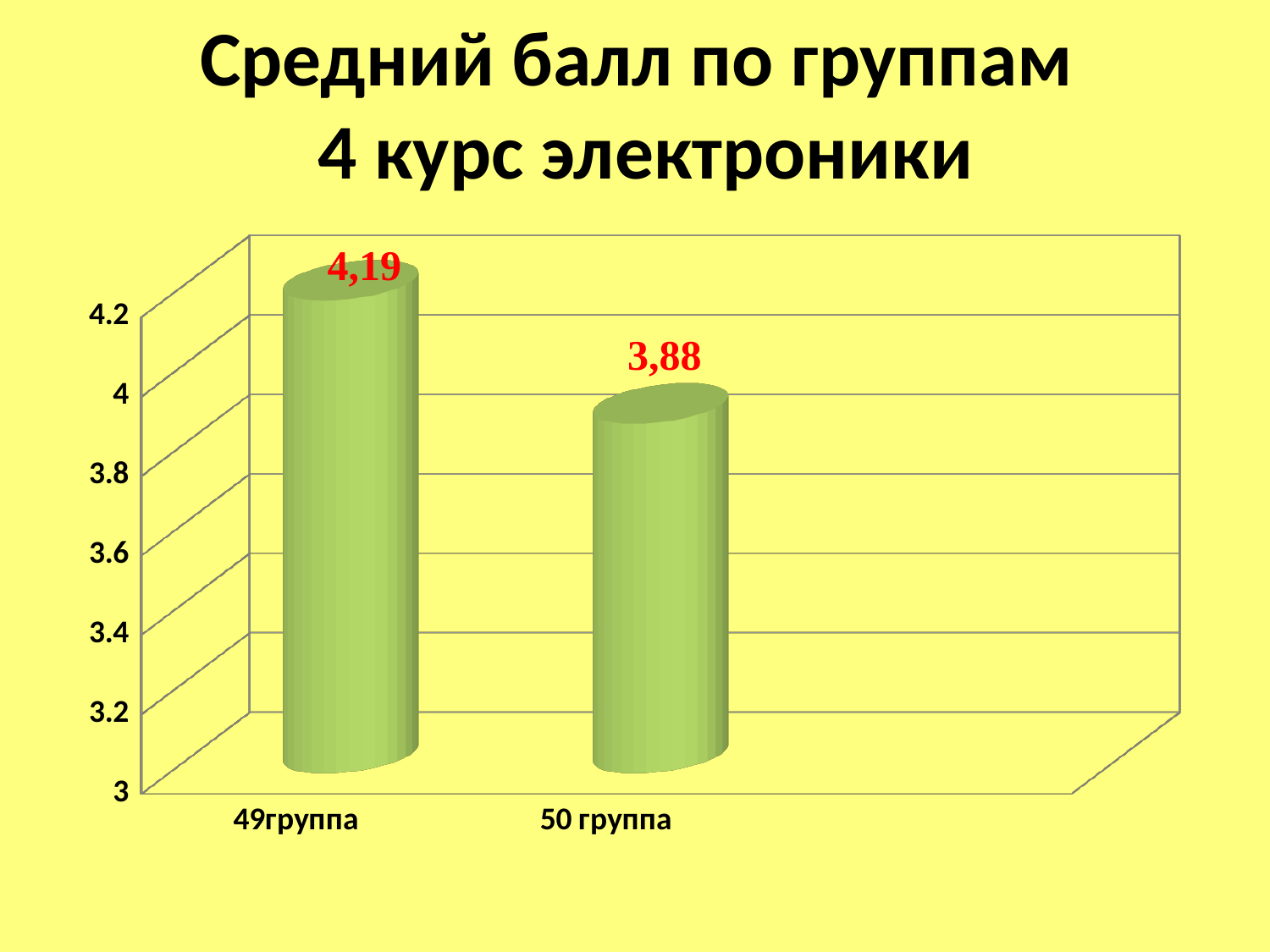
Which group has the highest average score? 49группа What is the difference between the average scores of 49группа and 50 группа? 0,31 Which group has a larger average score, 49группа or 50 группа? 49группа Which group has the lowest average score? 50 группа What is the average score for 50 группа? 3,88 Is the value for 49группа greater or less than 4? greater Do the values rise or fall from 49группа to 50 группа? fall What is the title of the slide? Средний балл по группам 4 курс электроники What kind of chart is shown on the slide? bar chart What is the average score for 49группа? 4,19 How many groups are shown on the chart? 2 Is the value for 50 группа greater or less than 4? less